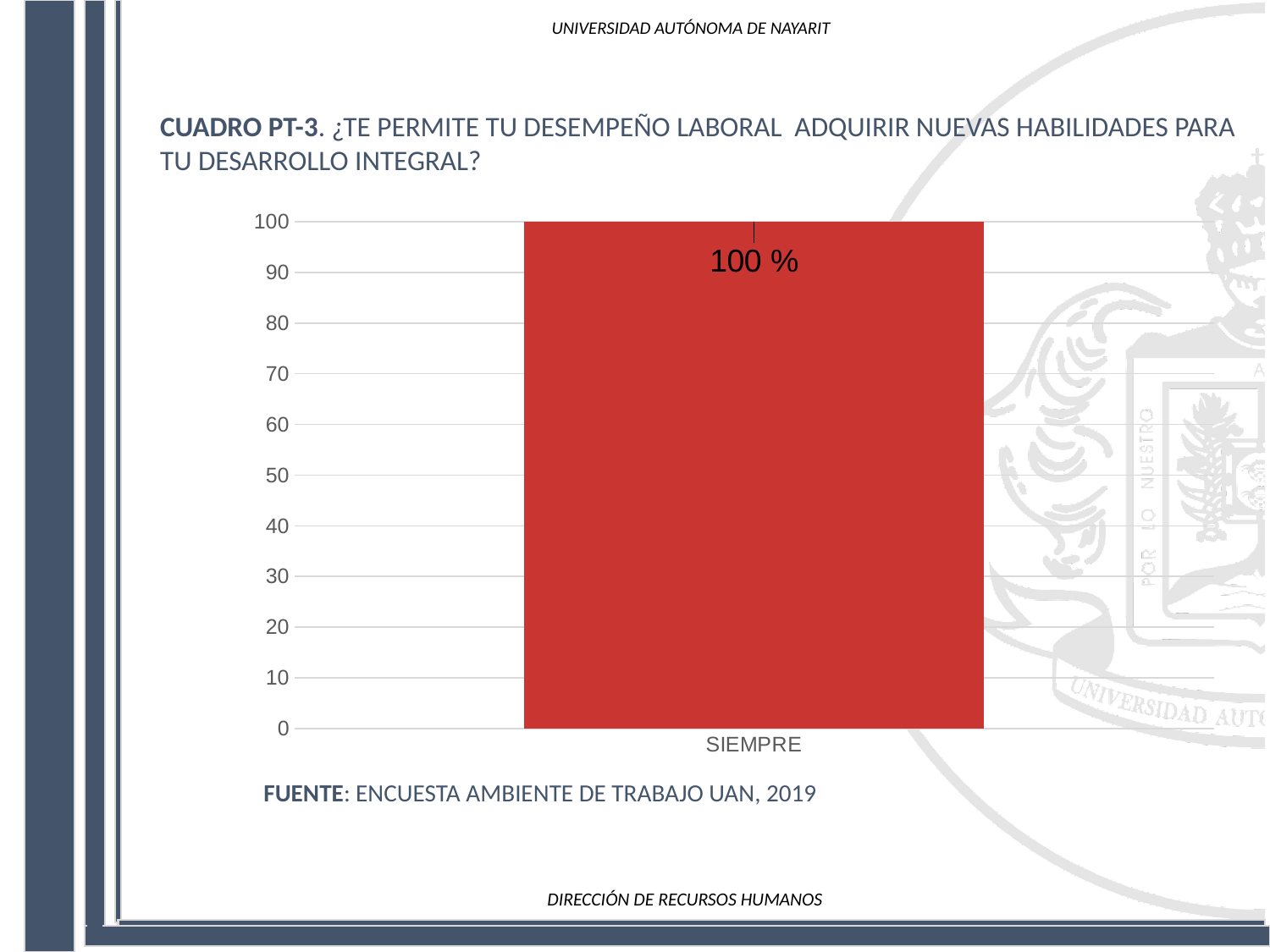
What is the highest value shown on the y axis? 100 What is the label of the only category on the x axis? SIEMPRE How many categories are plotted on the x axis? 1 What kind of chart is shown on the slide? bar chart Is the value for SIEMPRE greater or less than 50? greater Which category has the highest value? SIEMPRE What is the value shown for SIEMPRE? 100 %